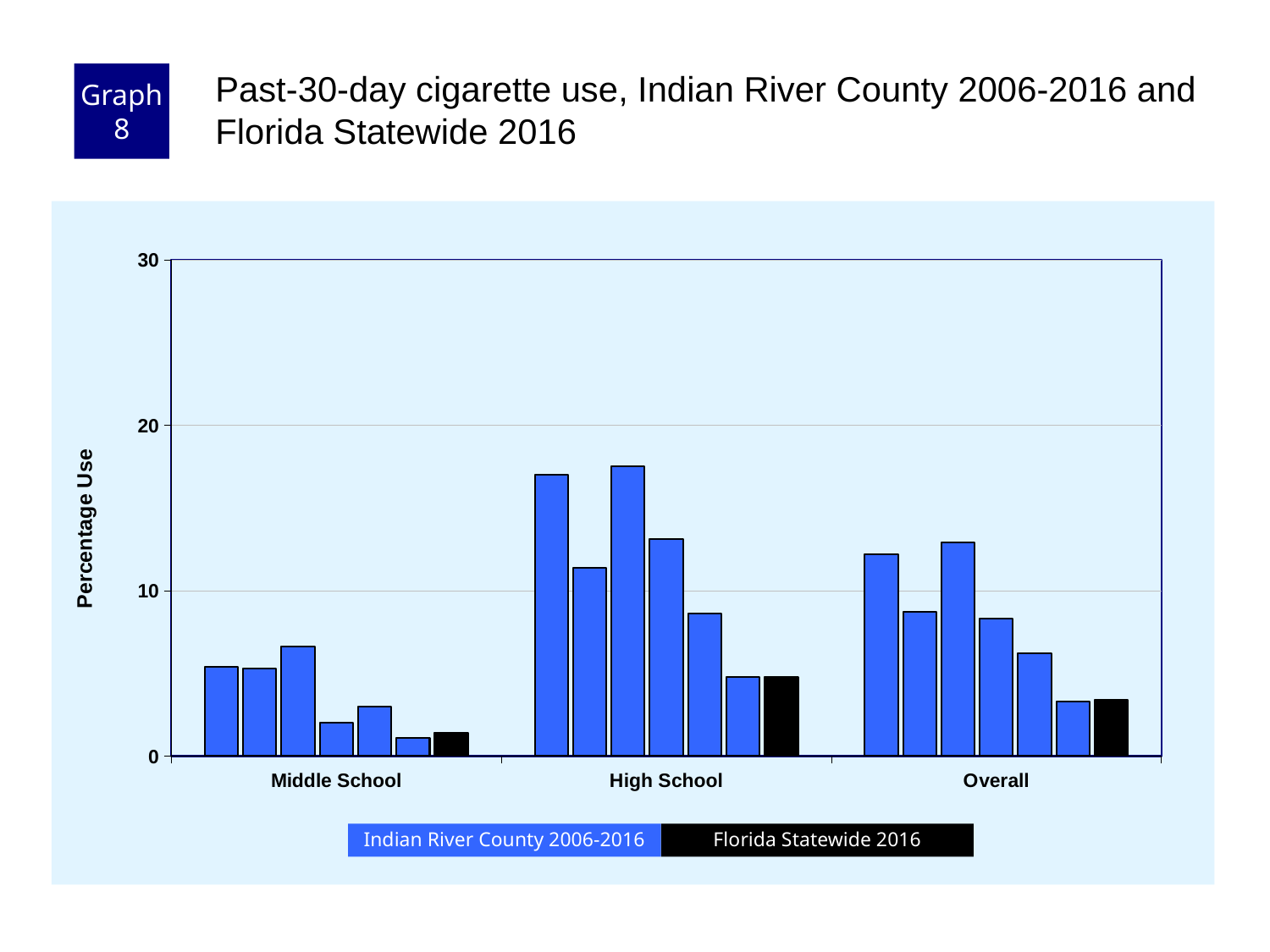
Within the High School category, is the last Indian River County 2006-2016 bar higher or lower than the first one? lower Is the value of the Florida Statewide 2016 bar for High School greater or less than 10? less What colour are the Florida Statewide 2016 bars in the chart? black Is the value of the first Indian River County 2006-2016 bar for High School greater or less than 10? greater How many series does the chart's legend list? 2 Is the value of the first Indian River County 2006-2016 bar for Overall greater or less than 10? greater What is the label on the y axis of the chart? Percentage Use Which is larger: the Florida Statewide 2016 bar for High School or the Florida Statewide 2016 bar for Middle School? High School Which category on the x axis contains the tallest bar in the chart? High School How many categories are shown along the x axis of the chart? 3 Which category on the x axis has the lowest bars overall? Middle School What kind of chart is shown on the slide? bar chart